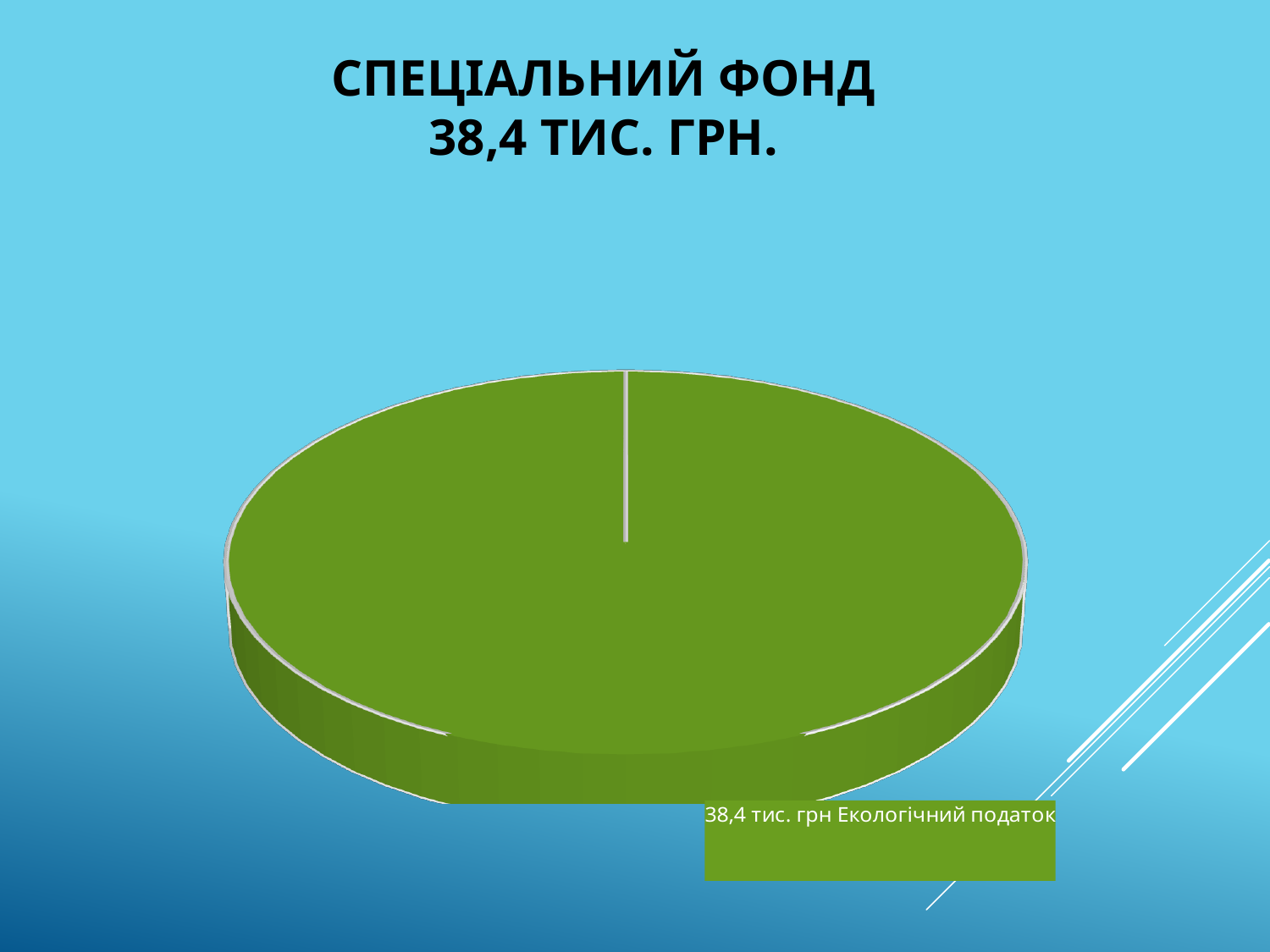
Which category is the largest slice of the pie chart? Екологічний податок What is the title of the chart? СПЕЦІАЛЬНИЙ ФОНД 38,4 ТИС. ГРН. What share of the pie does Екологічний податок represent? 100% How many slices does the pie chart have? 1 What is the value shown for Екологічний податок? 38,4 тис. грн What kind of chart is shown on the slide? pie chart What total amount does the chart title state for the special fund? 38,4 тис. грн. What colour is the slice for Екологічний податок? green